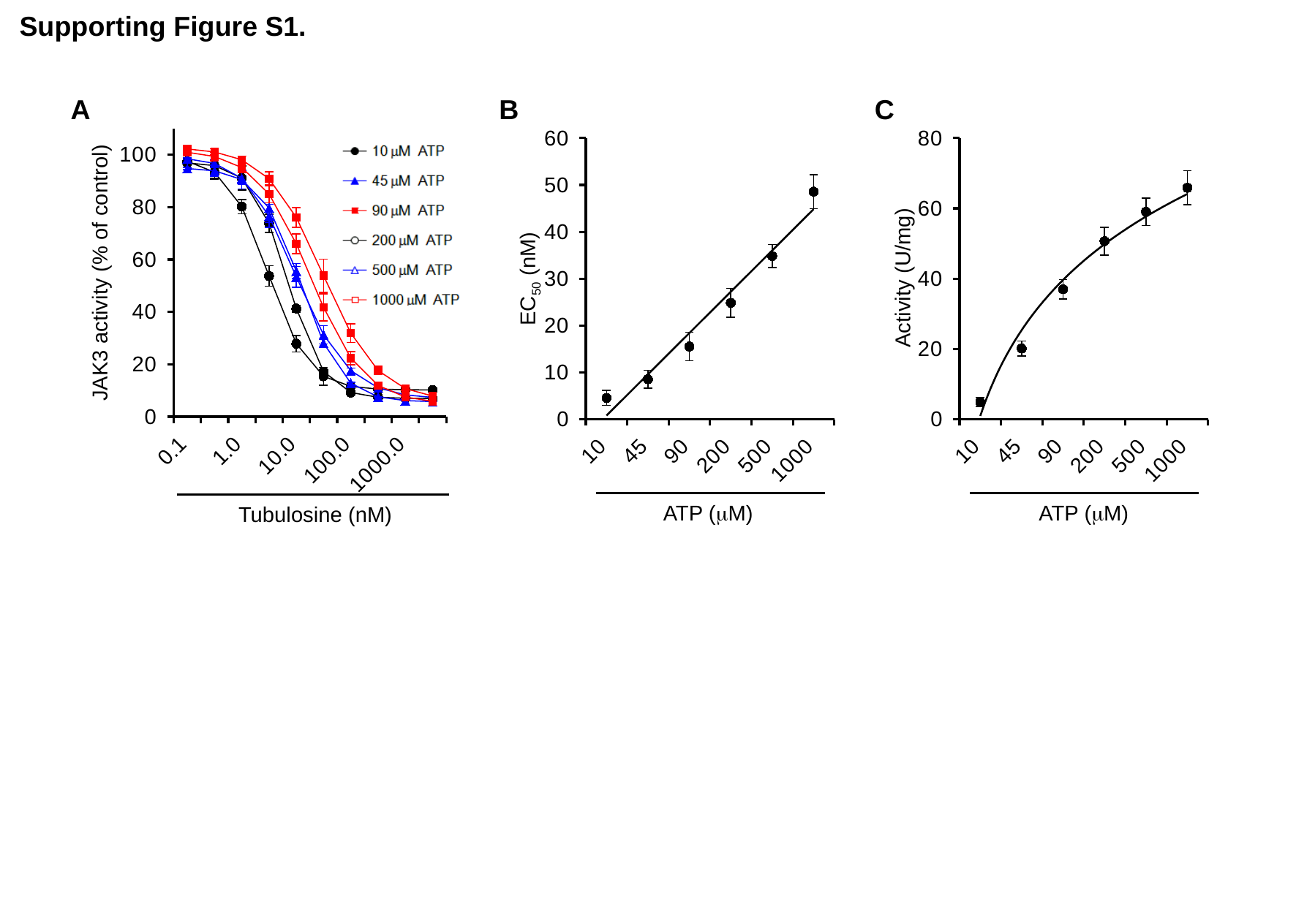
How many series does the legend of chart A list? 6 In chart C, is the activity at 10 µM ATP greater or less than 20? less In chart C, is the activity at 1000 µM ATP greater or less than 60? greater What is the x-axis label of chart A? Tubulosine (nM) In chart B, is the EC50 value at 1000 µM ATP greater or less than 40? greater In chart B, at which ATP concentration is the EC50 highest? 1000 What kind of chart is chart A? line chart What is the y-axis label of chart C? Activity (U/mg) In chart A, do the JAK3 activity values rise or fall as the tubulosine concentration increases? fall In chart B, do the EC50 values rise or fall as the ATP concentration increases? rise How many data points are plotted in chart B? 6